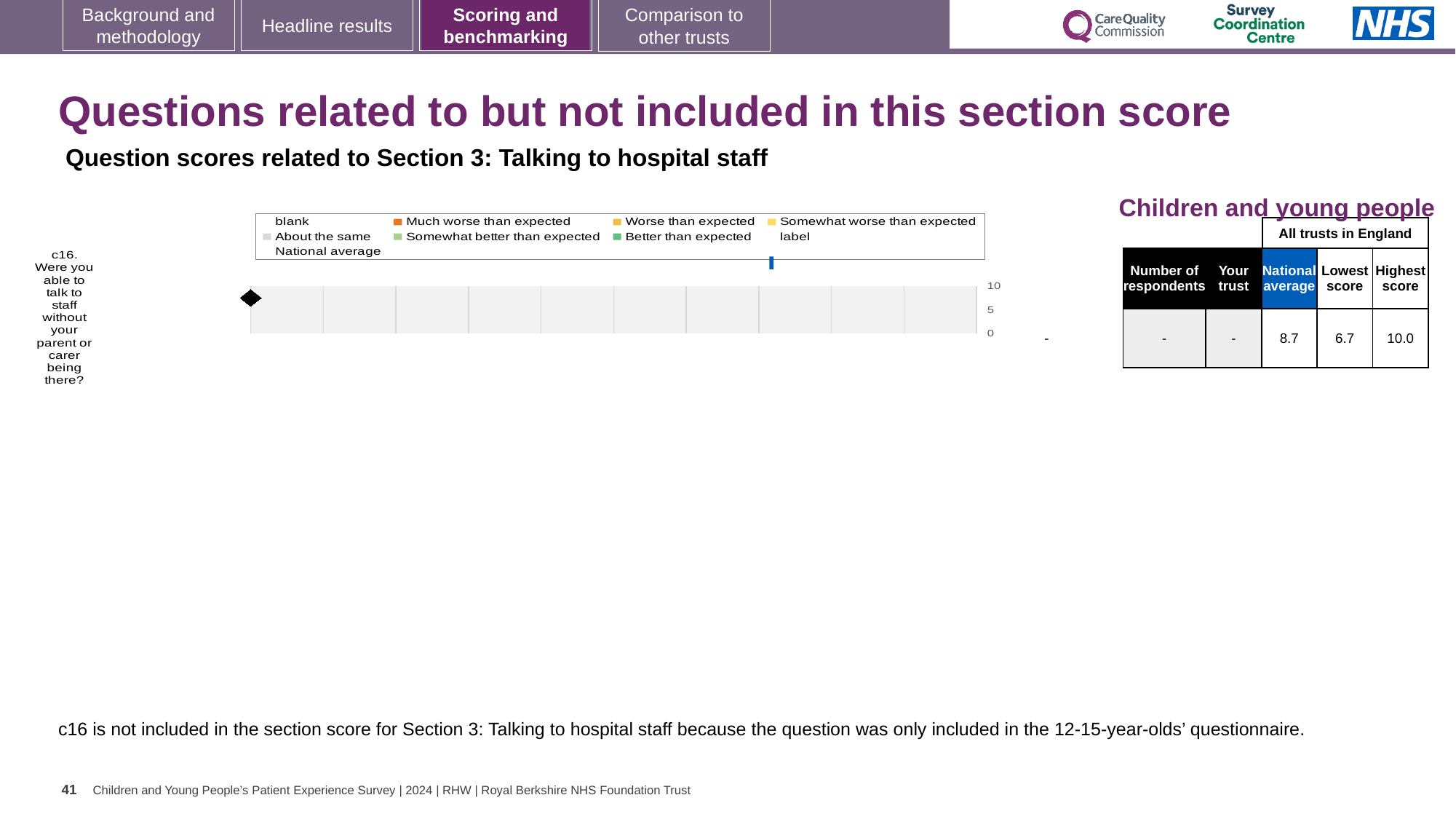
In the table, what is the national average score for c16? 8.7 How many entries does the chart's legend list? 9 What kind of chart is shown on the slide? bar chart In the table, what is the difference between the highest score and the lowest score for c16? 3.3 In the table, what is the highest score across all trusts in England for c16? 10.0 In the table, what is the lowest score across all trusts in England for c16? 6.7 In the table, what value is shown for 'Your trust' for c16? - What is the highest value shown on the chart's axis? 10 In the table, which is larger for c16: the national average or the lowest score? national average Which question is plotted on the chart? c16. Were you able to talk to staff without your parent or carer being there? How many question categories are plotted on the chart? 1